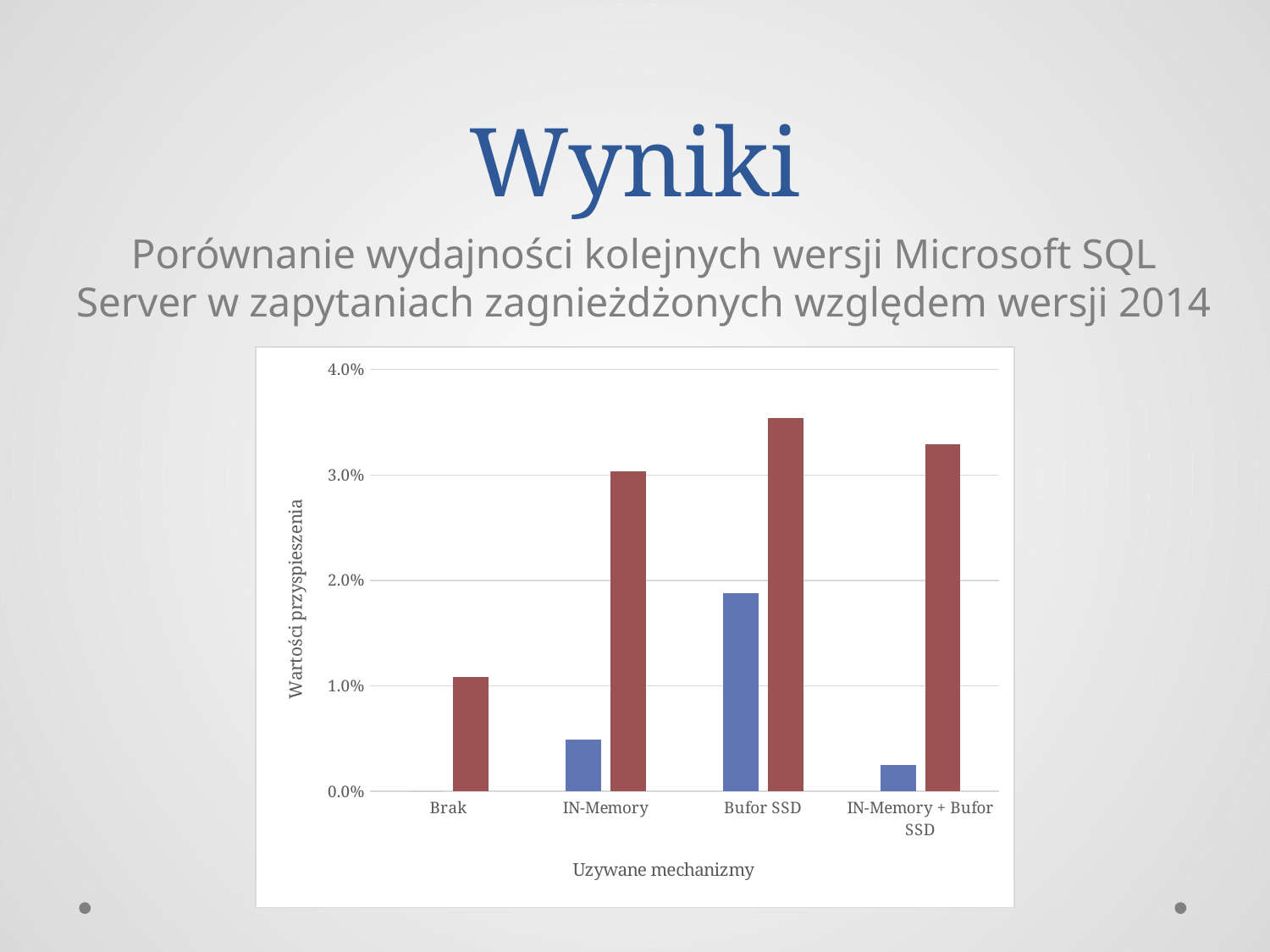
What is the title of the vertical axis of the chart? Wartości przyspieszenia What kind of chart is shown on the slide? bar chart Is the blue bar for Bufor SSD greater or less than 1.0%? greater Is the blue bar for IN-Memory greater or less than 1.0%? less How many categories are shown on the x axis of the chart? 4 What is the title of the horizontal axis of the chart? Uzywane mechanizmy Which is larger, the red bar for IN-Memory or the red bar for Brak? IN-Memory Is the red bar for Bufor SSD greater or less than 3.0%? greater Which category has the highest blue bar? Bufor SSD Which category has the lowest red bar? Brak Which category has the highest red bar? Bufor SSD